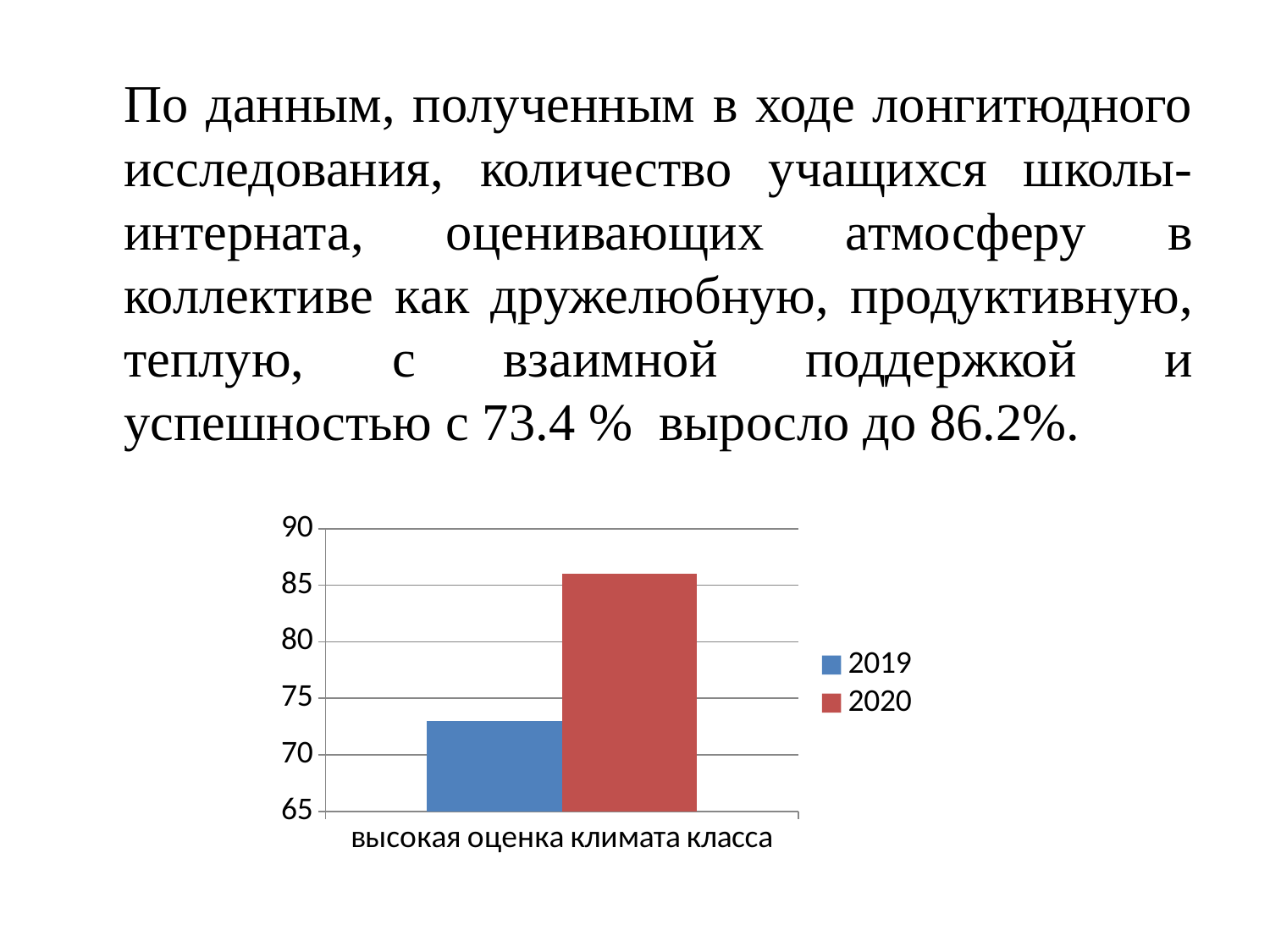
How many series does the legend list? 2 Is the value for 2019 greater or less than 75? less Is the value for 2020 greater or less than 90? less Which series has the higher bar, 2019 or 2020? 2020 How many categories are shown on the x axis of the chart? 1 What is the category label on the x axis of the chart? высокая оценка климата класса Which years are listed in the chart legend? 2019 and 2020 Which series has the lowest bar in the chart? 2019 Is the value for 2020 greater or less than 85? greater Which series has the highest bar in the chart? 2020 What kind of chart is shown on the slide? bar chart